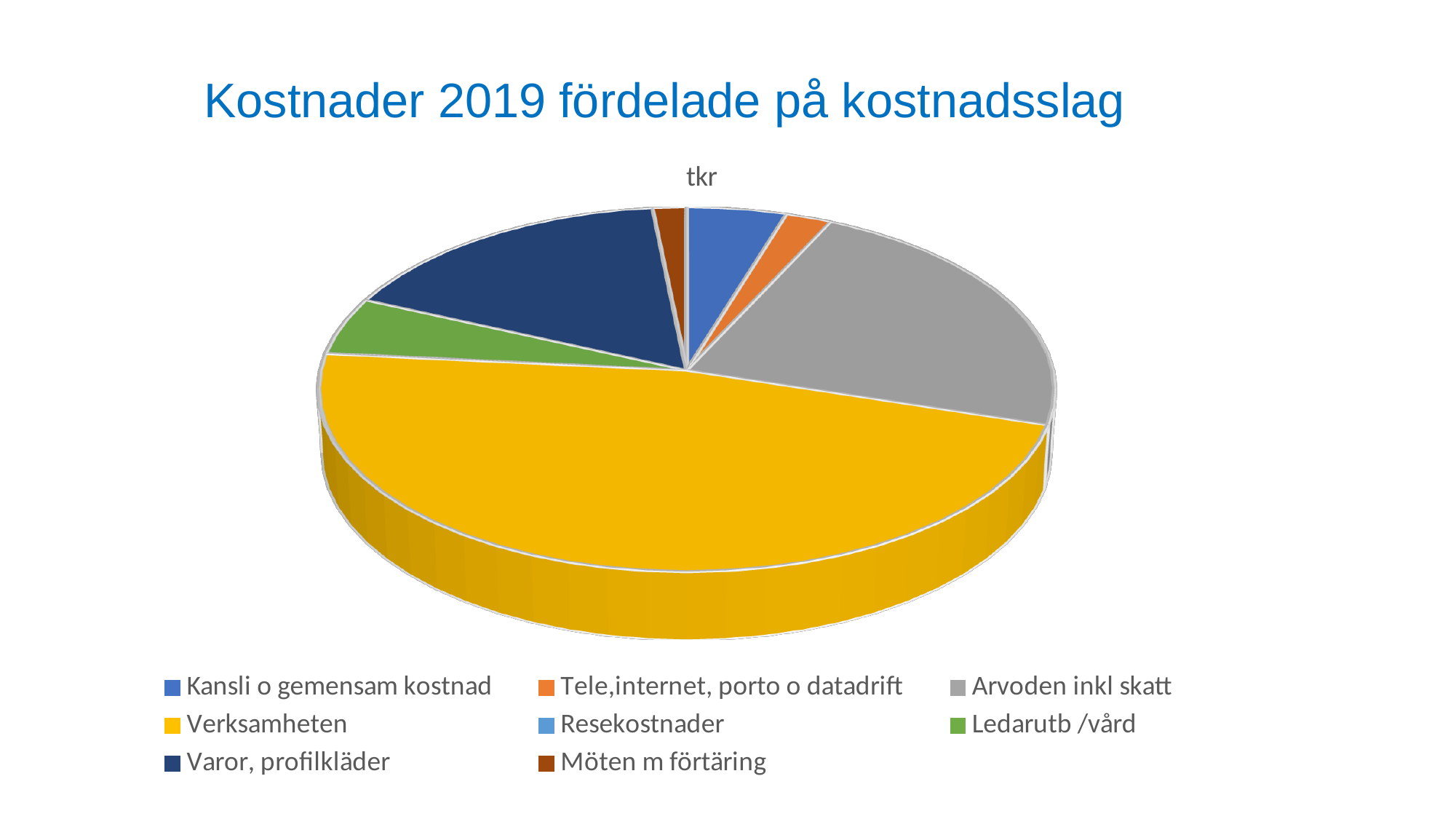
Which slice is larger, Verksamheten or Arvoden inkl skatt? Verksamheten What is the title of the slide? Kostnader 2019 fördelade på kostnadsslag Which slice is larger, Arvoden inkl skatt or Kansli o gemensam kostnad? Arvoden inkl skatt Which slice is larger, Varor, profilkläder or Ledarutb /vård? Varor, profilkläder How many categories does the legend list? 8 What unit label is shown above the pie chart? tkr Which category has the largest slice of the pie? Verksamheten What kind of chart is shown on the slide? pie chart